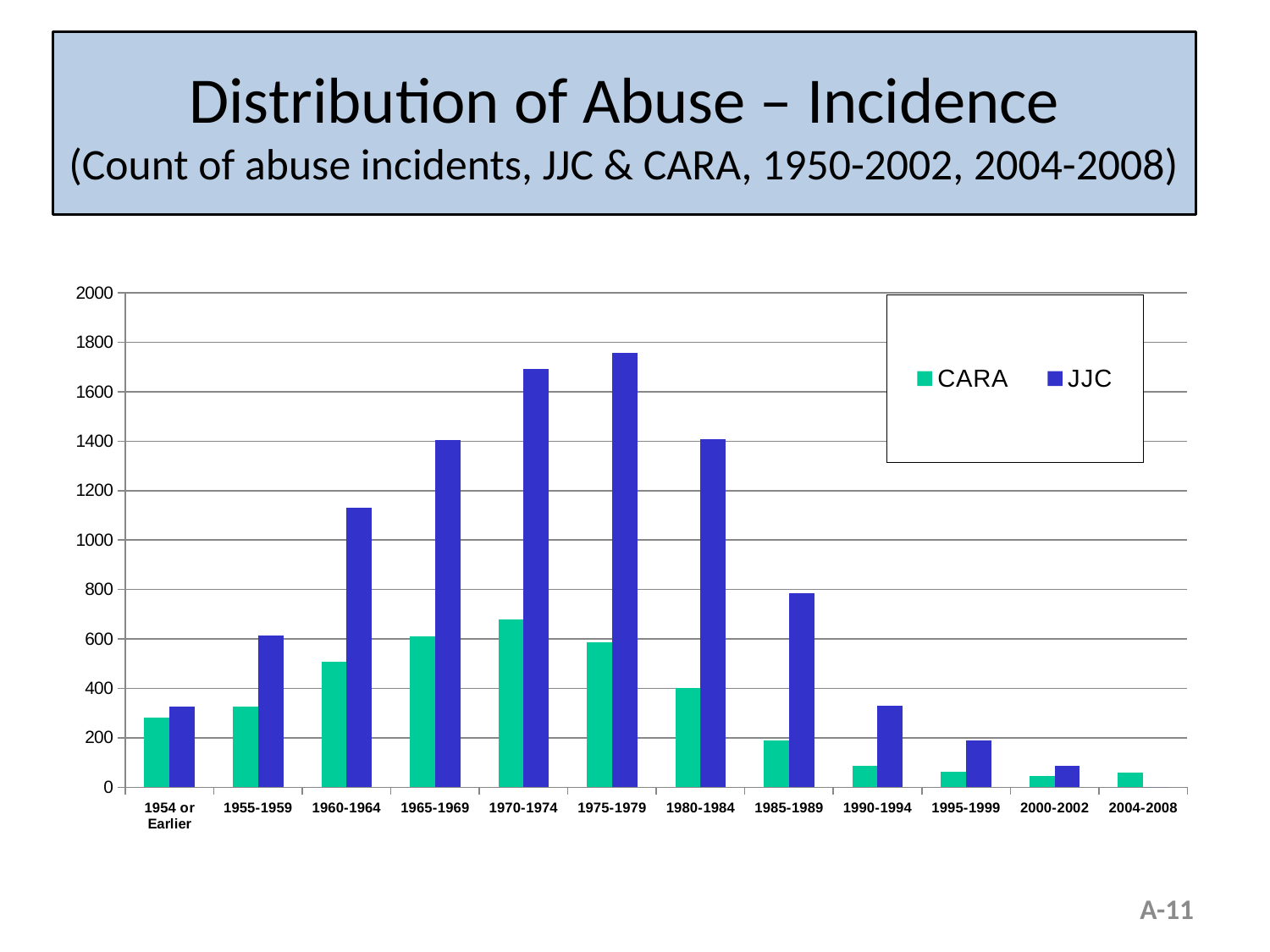
Do the JJC values rise or fall from 1975-1979 through 2000-2002? fall In which period is the CARA value highest? 1970-1974 For 1965-1969, which series has the larger value, CARA or JJC? JJC Is the JJC value for 1960-1964 greater or less than 1000? greater In which period is the JJC value highest? 1975-1979 Is the JJC value for 1970-1974 greater or less than 1600? greater What kind of chart is shown on the slide? bar chart Is the JJC value for 1985-1989 greater or less than 1000? less How many period categories are shown on the x axis? 12 How many series does the legend list? 2